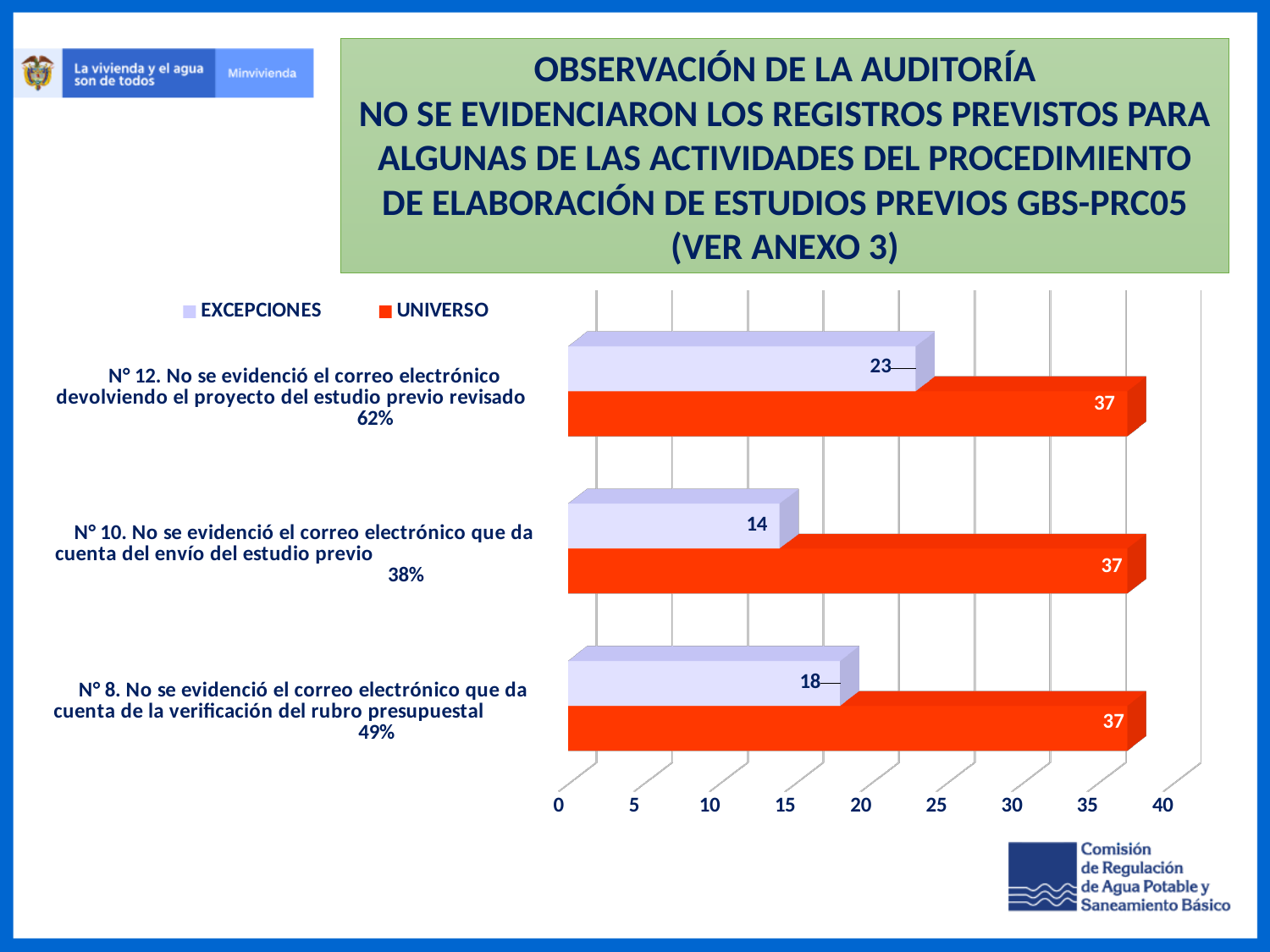
What is the difference between the EXCEPCIONES values for N° 8 and N° 10? 4 Which is larger, the EXCEPCIONES value for N° 12 or for N° 8? N° 12 What is the difference between the UNIVERSO and EXCEPCIONES values for N° 12? 14 What is the EXCEPCIONES value for N° 8 (No se evidenció el correo electrónico que da cuenta de la verificación del rubro presupuestal)? 18 What is the EXCEPCIONES value for N° 10 (No se evidenció el correo electrónico que da cuenta del envío del estudio previo)? 14 What is the EXCEPCIONES value for N° 12 (No se evidenció el correo electrónico devolviendo el proyecto del estudio previo revisado)? 23 What is the UNIVERSO value for N° 10? 37 How many series does the legend list? 2 Which category has the lowest EXCEPCIONES value? N° 10 Which category has the highest EXCEPCIONES value? N° 12 What kind of chart is shown on the slide? Bar chart How many categories are shown in the chart? 3